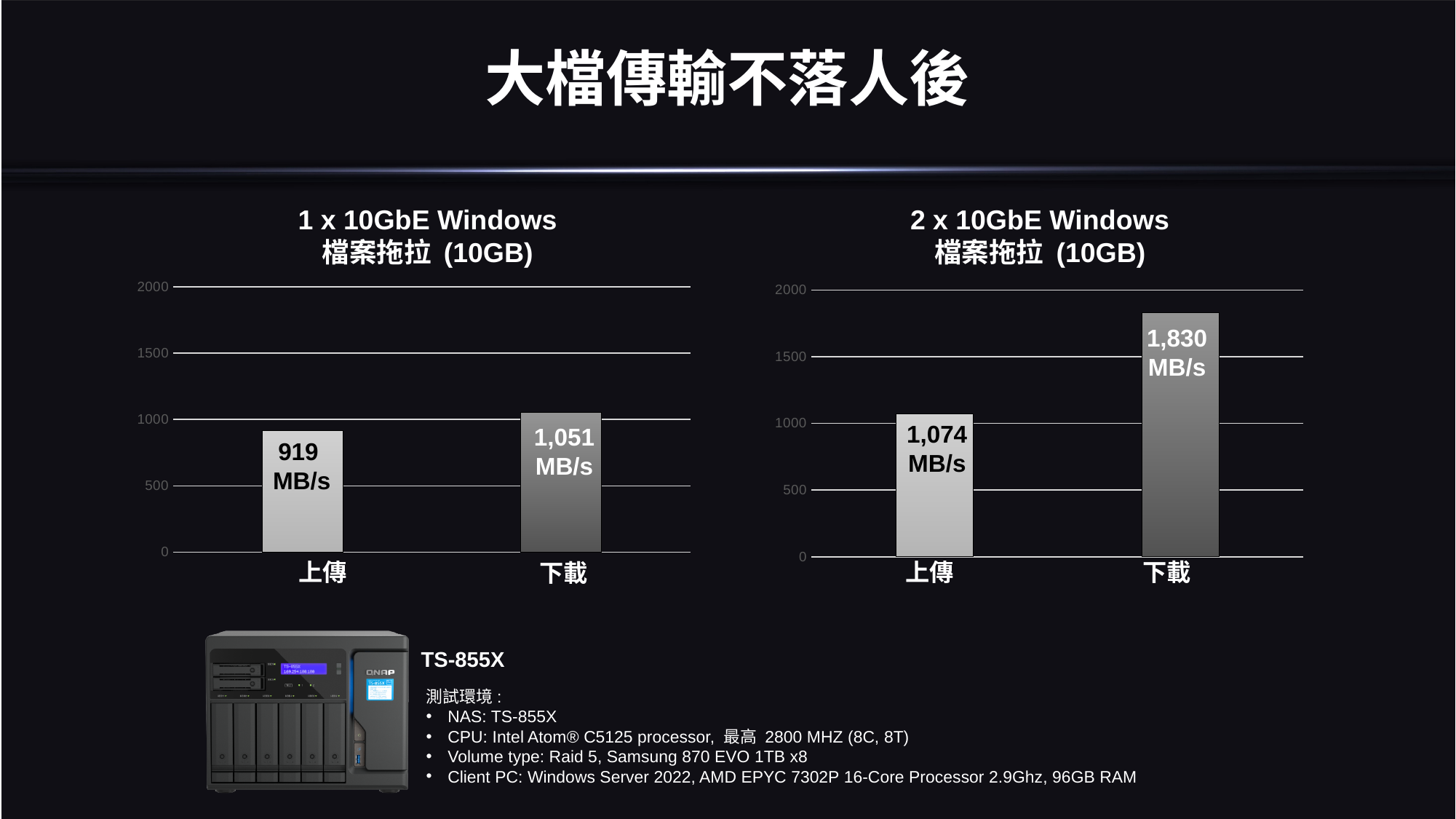
In the left chart (1 x 10GbE Windows 檔案拖拉 (10GB)), what is the value for 上傳? 919 MB/s In the right chart (2 x 10GbE Windows 檔案拖拉 (10GB)), which category has the highest value? 下載 Which is larger: 下載 in the left chart (1 x 10GbE) or 上傳 in the right chart (2 x 10GbE)? 上傳 in the right chart (2 x 10GbE) In the right chart (2 x 10GbE Windows 檔案拖拉 (10GB)), what is the value for 上傳? 1,074 MB/s In the right chart (2 x 10GbE Windows 檔案拖拉 (10GB)), what is the value for 下載? 1,830 MB/s In the left chart (1 x 10GbE Windows 檔案拖拉 (10GB)), what is the difference between 下載 and 上傳? 132 MB/s What kind of chart is the left chart (1 x 10GbE Windows 檔案拖拉 (10GB))? Bar chart How many categories are shown in the right chart (2 x 10GbE Windows 檔案拖拉 (10GB))? 2 In the left chart (1 x 10GbE Windows 檔案拖拉 (10GB)), what is the value for 下載? 1,051 MB/s In the left chart (1 x 10GbE Windows 檔案拖拉 (10GB)), which category has the lowest value? 上傳 In the left chart (1 x 10GbE Windows 檔案拖拉 (10GB)), is the value for 上傳 greater or less than 1000? less In the right chart (2 x 10GbE Windows 檔案拖拉 (10GB)), what is the difference between 下載 and 上傳? 756 MB/s